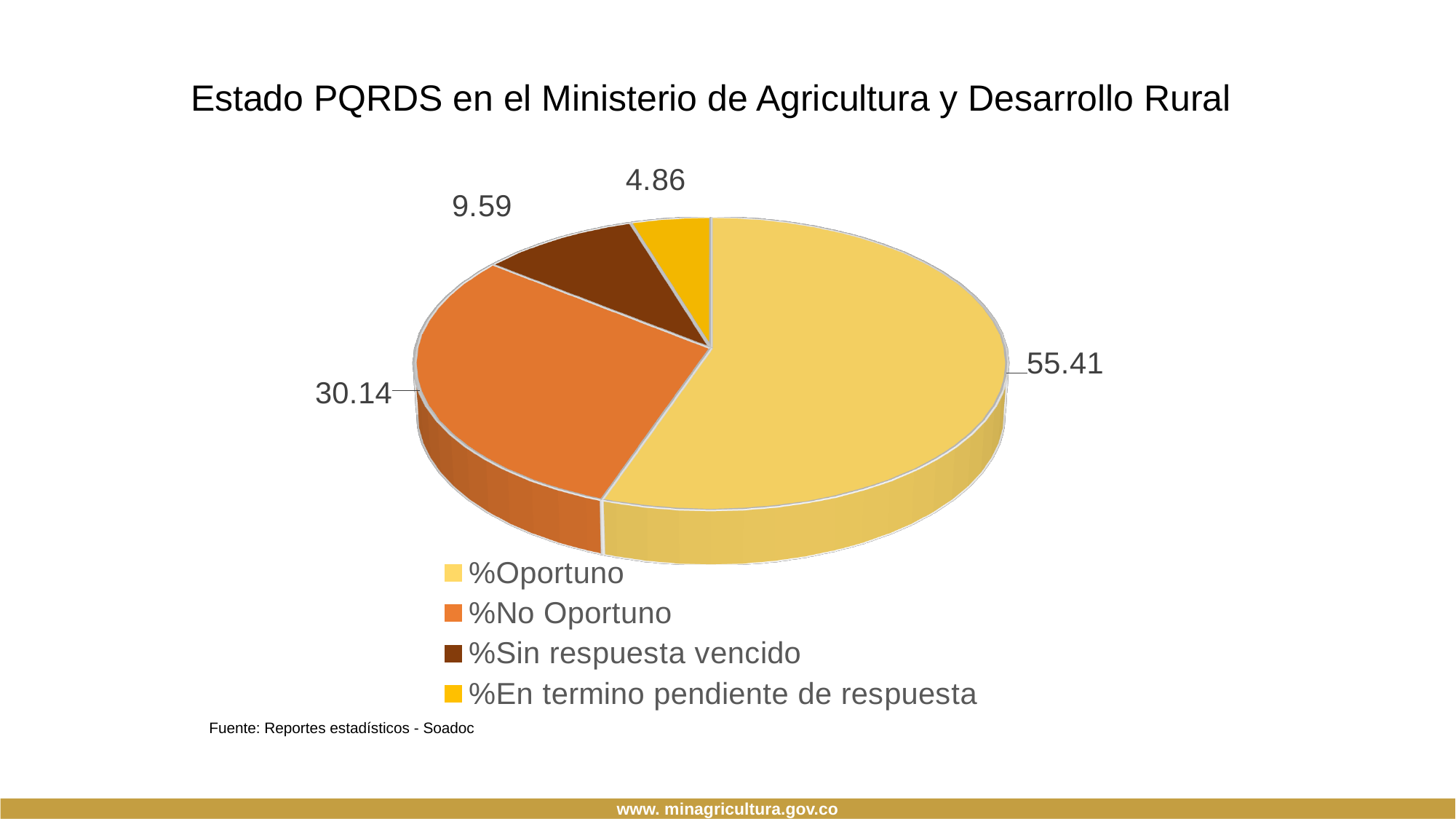
How many slices does the pie chart have? 4 What is the value for %No Oportuno? 30.14 Which is larger, %Sin respuesta vencido or %En termino pendiente de respuesta? %Sin respuesta vencido What is the value for %En termino pendiente de respuesta? 4.86 What colour is the %No Oportuno slice? Orange What is the value for %Oportuno? 55.41 Which category has the smallest slice? %En termino pendiente de respuesta Which category has the largest slice? %Oportuno What kind of chart is shown on the slide? Pie chart What is the value for %Sin respuesta vencido? 9.59 What is the title of the chart? Estado PQRDS en el Ministerio de Agricultura y Desarrollo Rural What is the difference between the values for %Oportuno and %No Oportuno? 25.27